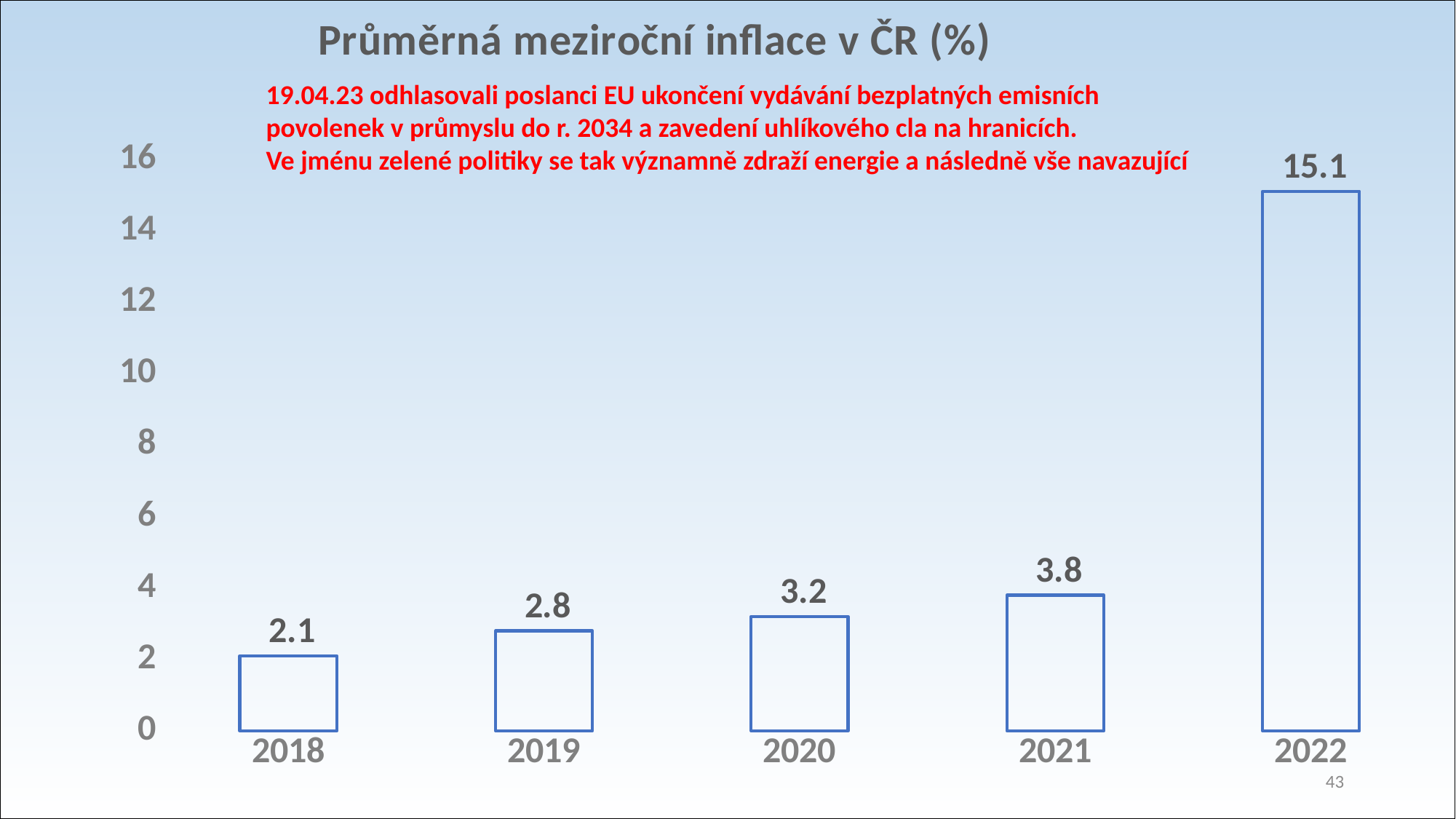
What is the value for 2020? 3.2 What is the value for 2022? 15.1 Which year has the lowest value? 2018 Do the values rise or fall from 2018 to 2022? rise What kind of chart is shown on the slide? bar chart What is the difference between the values for 2019 and 2018? 0.7 What is the value for 2018? 2.1 What is the difference between the values for 2022 and 2021? 11.3 How many years are shown on the x axis? 5 Which year has the highest value? 2022 Which is larger, the value for 2020 or the value for 2021? 2021 Is the value for 2022 greater or less than 14? greater